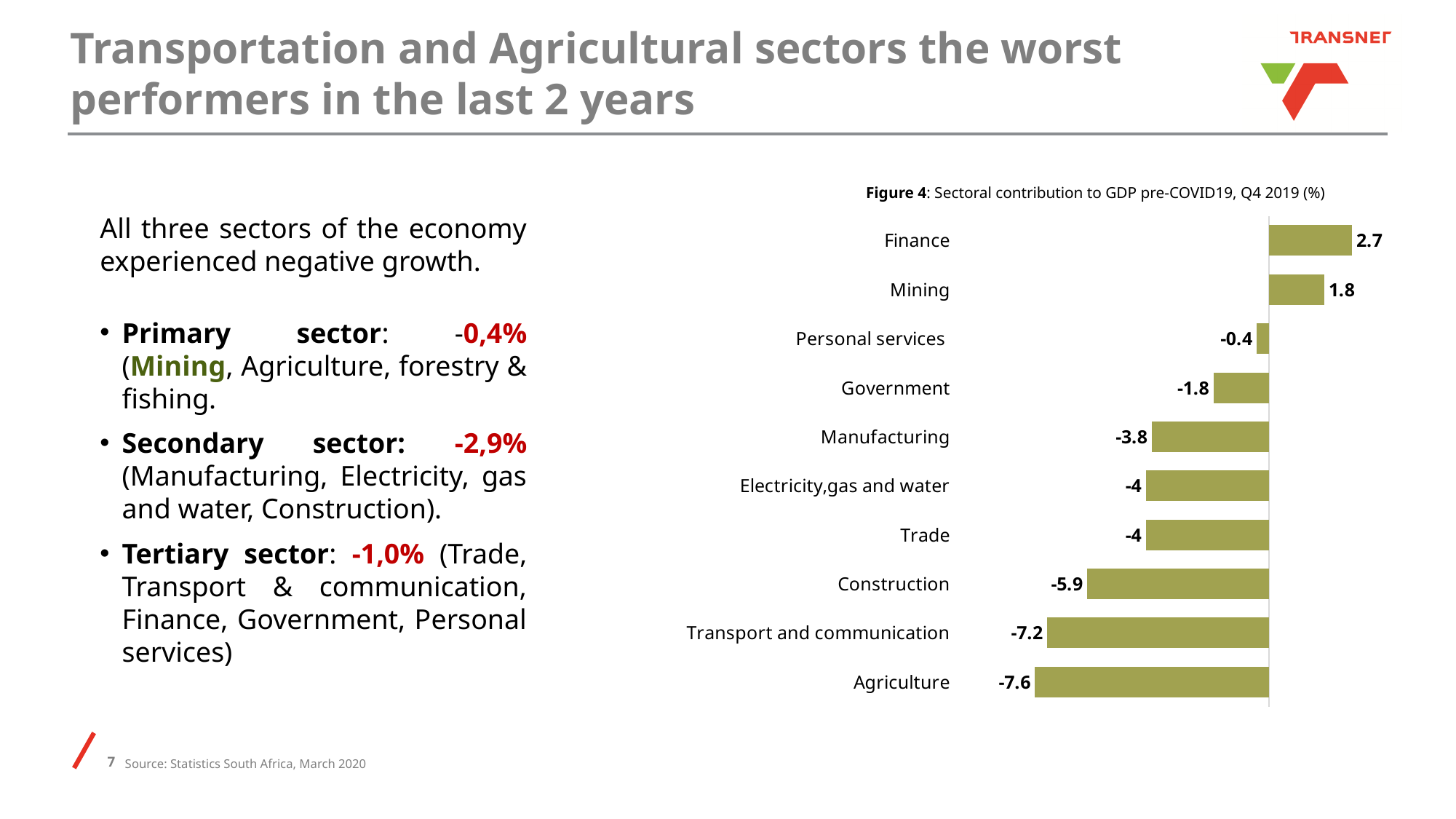
How many sectors are shown in the chart? 10 Which has the larger value, Government or Construction? Government What is the difference between the values for Finance and Mining? 0.9 What is the difference between the values for Agriculture and Transport and communication? 0.4 What is the title of the chart? Figure 4: Sectoral contribution to GDP pre-COVID19, Q4 2019 (%) What is the value for Finance in the chart? 2.7 Which sector has the highest value in the chart? Finance What is the value for Transport and communication in the chart? -7.2 How many sectors in the chart have a positive value? 2 Which sector has the lowest value in the chart? Agriculture What is the value for Manufacturing in the chart? -3.8 What kind of chart is shown on the slide? Bar chart